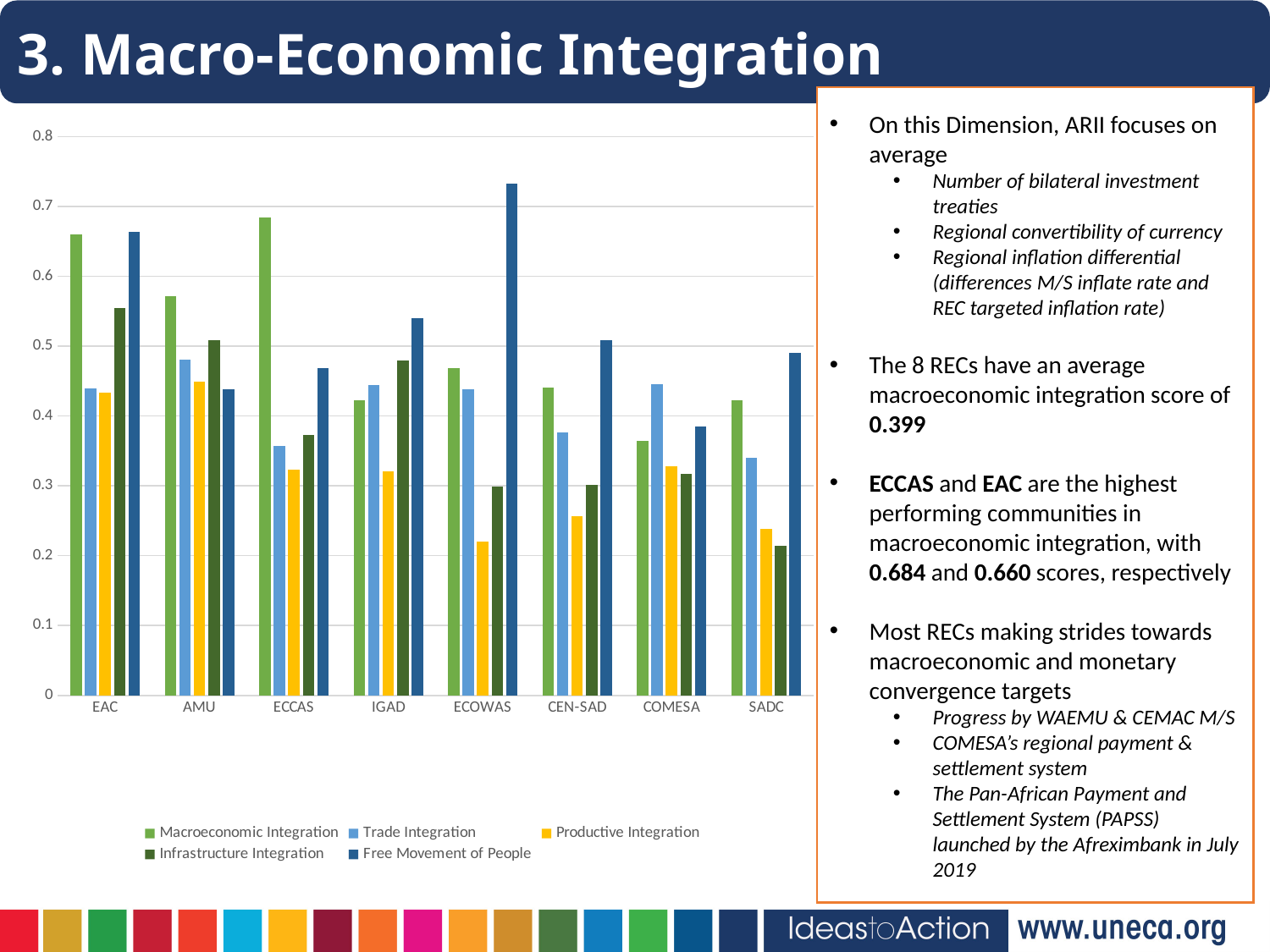
What is the Macroeconomic Integration score for ECCAS? 0.684 How many series does the chart legend list? 5 How many regional economic communities (categories) are shown on the x axis of the chart? 8 Which has the larger Trade Integration value, AMU or SADC? AMU What is the Macroeconomic Integration score for EAC? 0.660 Which community has the lowest Macroeconomic Integration score in the chart? COMESA Which community has the highest Free Movement of People score? ECOWAS Which community has the lowest Infrastructure Integration score? SADC What type of chart is shown on the slide? Bar chart Which community has the highest Macroeconomic Integration score in the chart? ECCAS Is the Free Movement of People value for ECOWAS greater or less than 0.7? greater Is the Productive Integration value for ECOWAS greater or less than 0.3? less